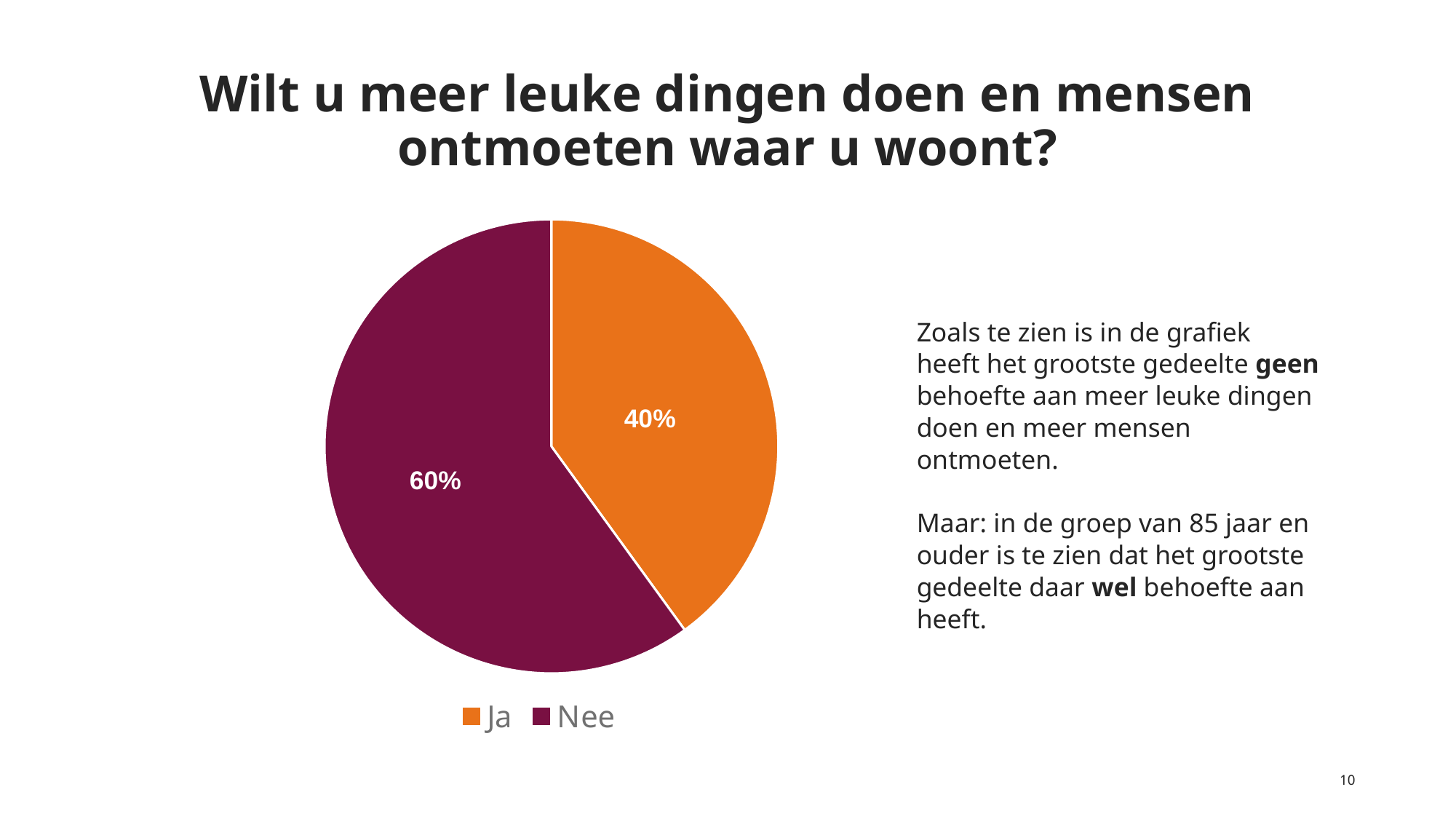
What share of the pie does the "Nee" slice represent? 60% Which answer has the smallest share of the pie? Ja What kind of chart is shown on the slide? pie chart What percentage of respondents answered "Ja"? 40% What is the title of the slide above the chart? Wilt u meer leuke dingen doen en mensen ontmoeten waar u woont? Which answer has the largest share of the pie? Nee What is the difference in percentage points between "Nee" and "Ja"? 20 What colour is the "Ja" slice? orange Which is larger, the share for "Ja" or the share for "Nee"? Nee How many entries does the legend list? 2 How many slices does the pie chart have? 2 What percentage of respondents answered "Nee"? 60%